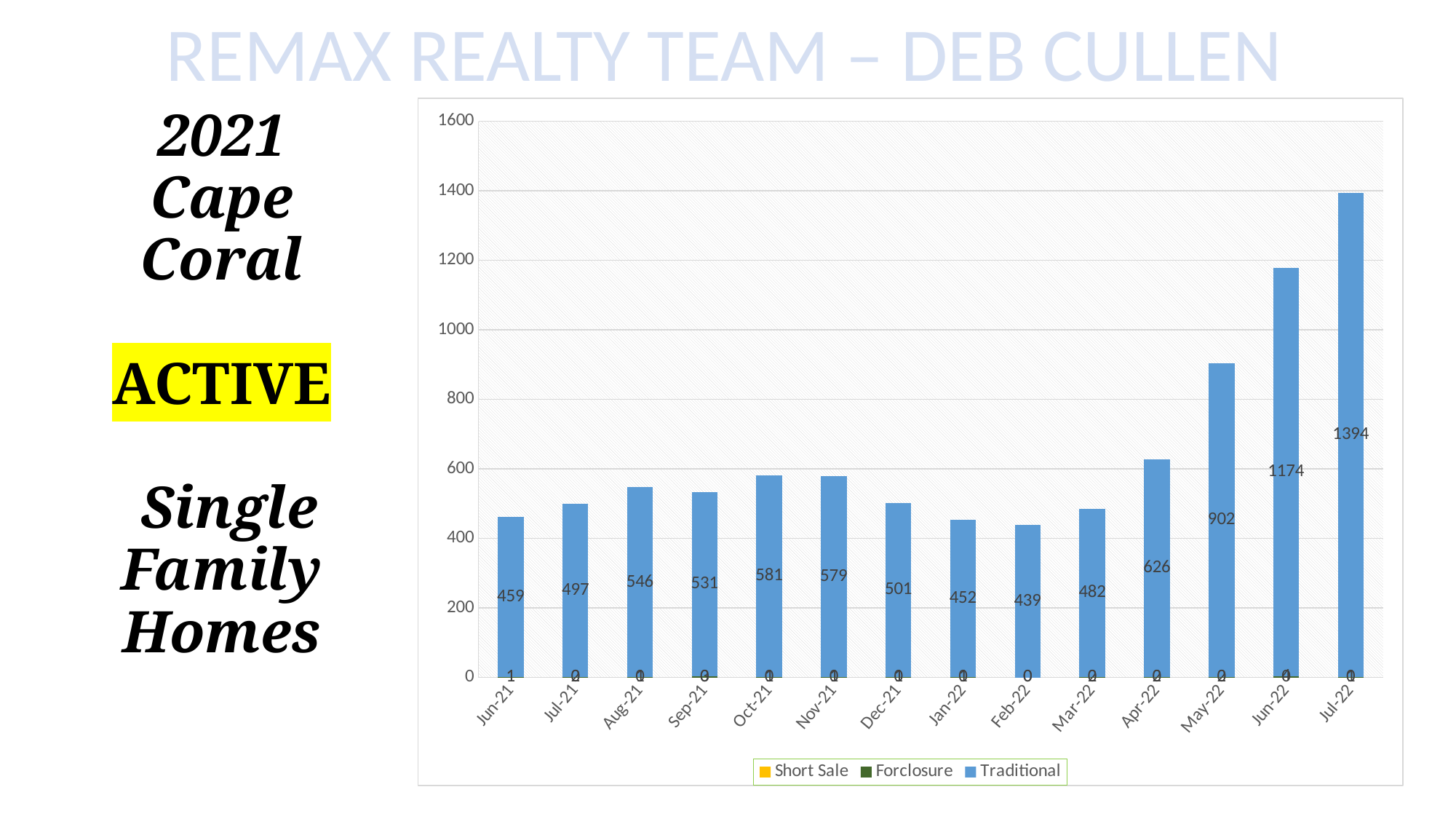
What kind of chart is shown on the slide? bar chart What is the difference between the Traditional values for May-22 and Apr-22? 276 How many series does the legend list? 3 What is the difference between the Traditional values for Jul-22 and Jun-22? 220 How many months are shown on the x axis? 14 Is the Traditional value for May-22 greater or less than 800? greater Which is larger, the Traditional value for Aug-21 or for Sep-21? Aug-21 Which month has the lowest Traditional value? Feb-22 What is the Traditional value for Jul-22? 1394 What is the Traditional value for Feb-22? 439 What is the Traditional value for Oct-21? 581 Which month has the highest Traditional value? Jul-22